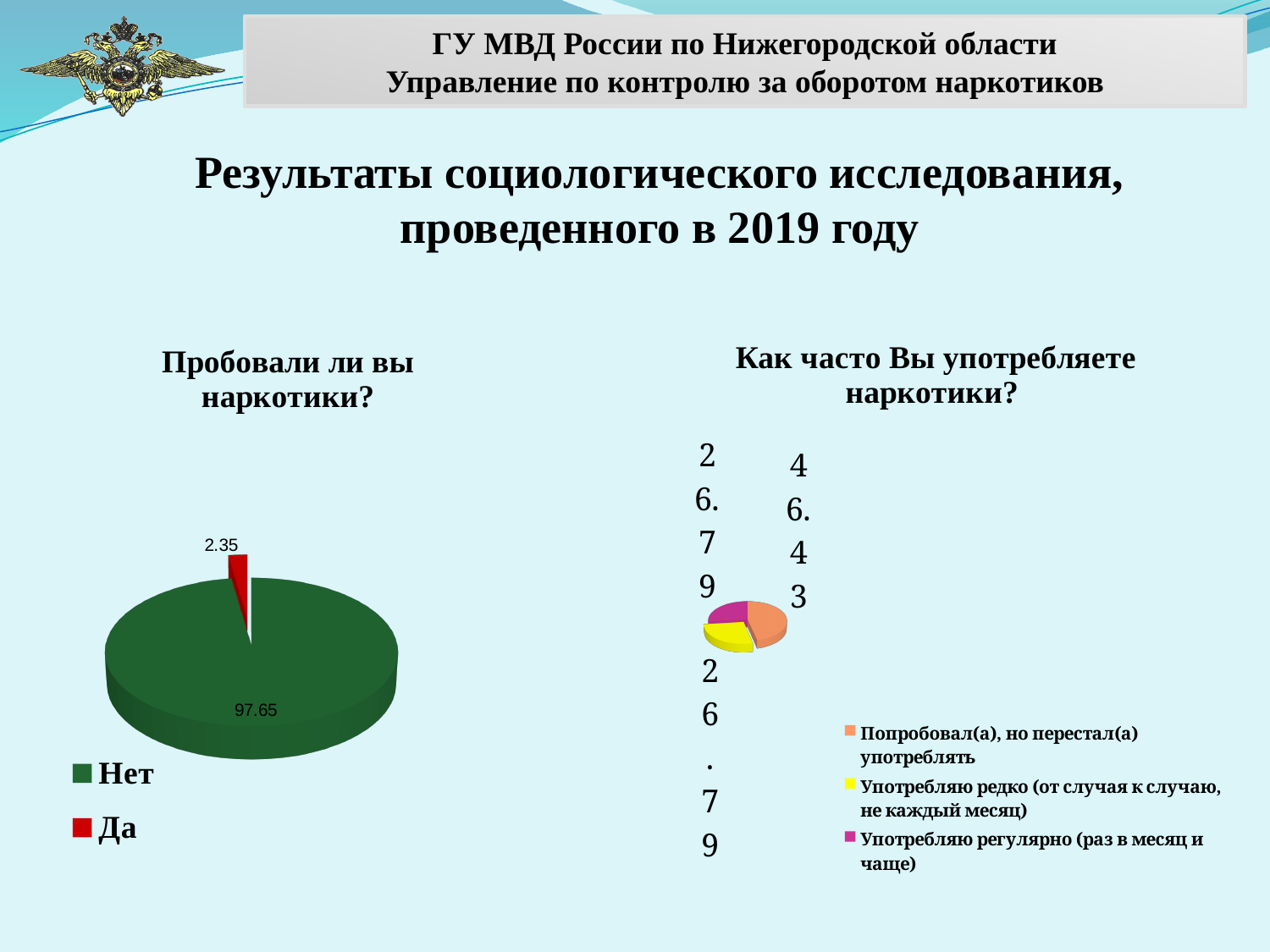
On the left chart 'Пробовали ли вы наркотики?', which category has the smallest slice? Да On the left chart 'Пробовали ли вы наркотики?', which category has the largest slice? Нет What type of chart is the left chart 'Пробовали ли вы наркотики?'? Pie chart On the right chart 'Как часто Вы употребляете наркотики?', which category has the largest slice? Попробовал(а), но перестал(а) употреблять On the left chart 'Пробовали ли вы наркотики?', what colour is the slice for 'Да'? Red What type of chart is the right chart 'Как часто Вы употребляете наркотики?'? Pie chart On the left chart 'Пробовали ли вы наркотики?', what is the difference between the values for 'Нет' and 'Да'? 95.3 On the right chart 'Как часто Вы употребляете наркотики?', how many categories does the legend list? 3 On the left chart 'Пробовали ли вы наркотики?', what is the value for 'Да'? 2.35 On the left chart 'Пробовали ли вы наркотики?', how many categories does the legend list? 2 On the right chart 'Как часто Вы употребляете наркотики?', what colour is the slice for 'Употребляю редко (от случая к случаю, не каждый месяц)'? Yellow On the left chart 'Пробовали ли вы наркотики?', what is the value for 'Нет'? 97.65